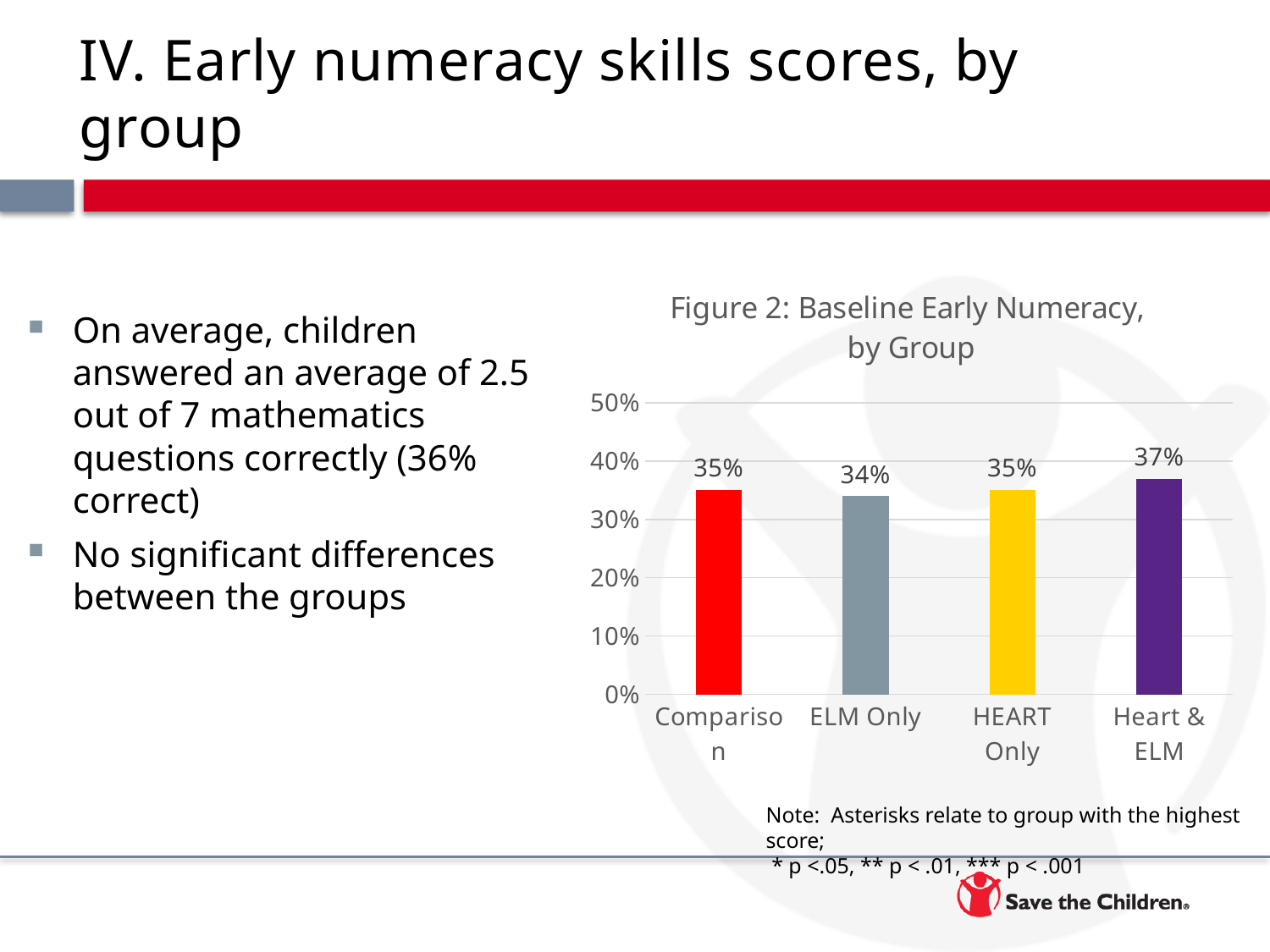
What kind of chart is shown? bar chart What is the value for Comparison? 35% Is the value for Heart & ELM greater or less than 40%? less How many groups are shown on the x axis? 4 What is the title of the chart? Figure 2: Baseline Early Numeracy, by Group What is the difference between the values for Heart & ELM and ELM Only? 3% Which group has the highest value? Heart & ELM Which group has the lowest value? ELM Only What is the value for HEART Only? 35% Which is larger, the value for Heart & ELM or the value for ELM Only? Heart & ELM What is the value for ELM Only? 34% What is the value for Heart & ELM? 37%